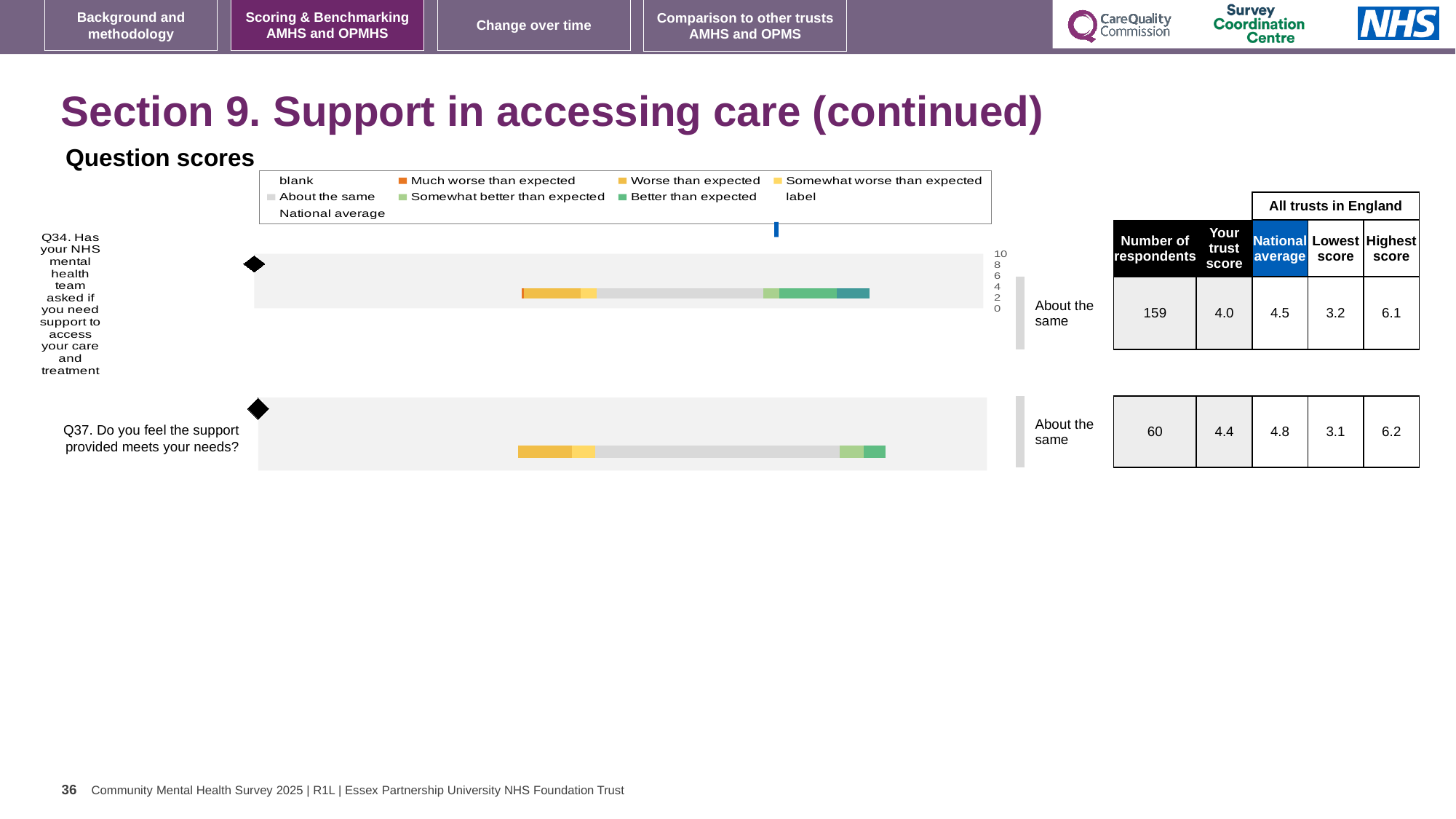
What is the benchmark label shown next to the bar for Q34? About the same Which question has the higher trust score, Q34 or Q37? Q37 What is the national average for Q37 (Do you feel the support provided meets your needs)? 4.8 How many respondents answered Q34? 159 What is the benchmark label shown next to the bar for Q37? About the same What is the highest score among all trusts in England for Q37? 6.2 What is the trust score for Q34 (Has your NHS mental health team asked if you need support to access your care and treatment)? 4.0 Which question has the lower number of respondents, Q34 or Q37? Q37 How many questions (categories) are plotted in the question scores chart? 2 What is the difference between the national average and the trust score for Q34? 0.5 What kind of chart is used to show the question scores for Q34 and Q37? Stacked bar chart Which legend entry is shown in orange in the question scores chart? Much worse than expected